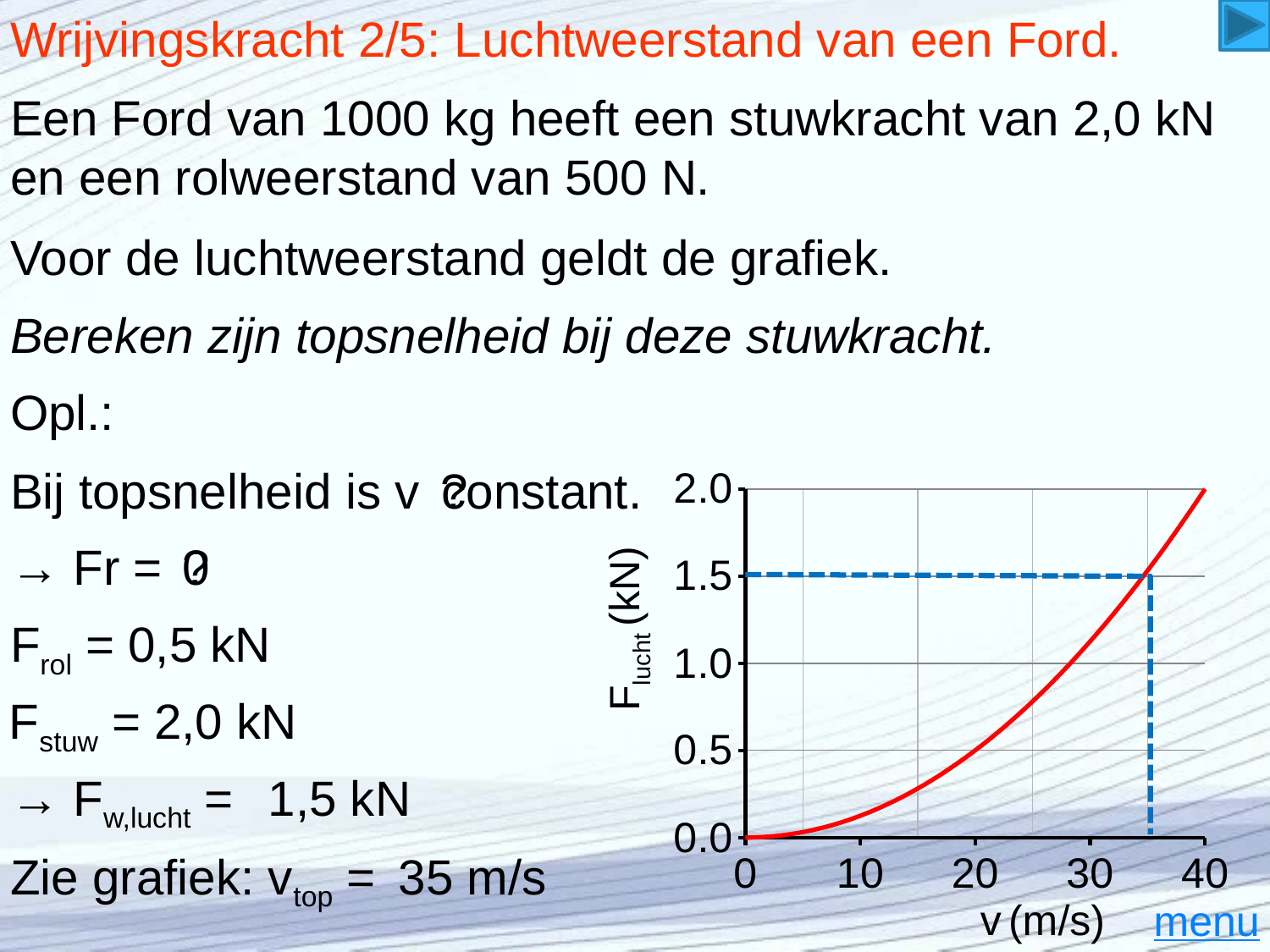
How many labelled tick marks are there on the x axis of the chart? 5 What is the label of the x axis of the chart? v (m/s) What kind of chart is shown on the slide? line chart What is the label of the y axis of the chart? F_lucht (kN) Does the value of F_lucht rise or fall as v increases along the x axis? rise Is the value of F_lucht at v = 30 m/s greater or less than 1.0 kN? greater According to the dashed lines on the chart, at what speed v does F_lucht equal 1.5 kN? 35 m/s Is the value of F_lucht at v = 35 m/s greater or less than 1.0 kN? greater What is the highest value shown on the y axis of the chart? 2.0 Is the value of F_lucht at v = 40 m/s greater or less than 1.5 kN? greater Which is larger: F_lucht at v = 20 m/s or F_lucht at v = 35 m/s? F_lucht at v = 35 m/s